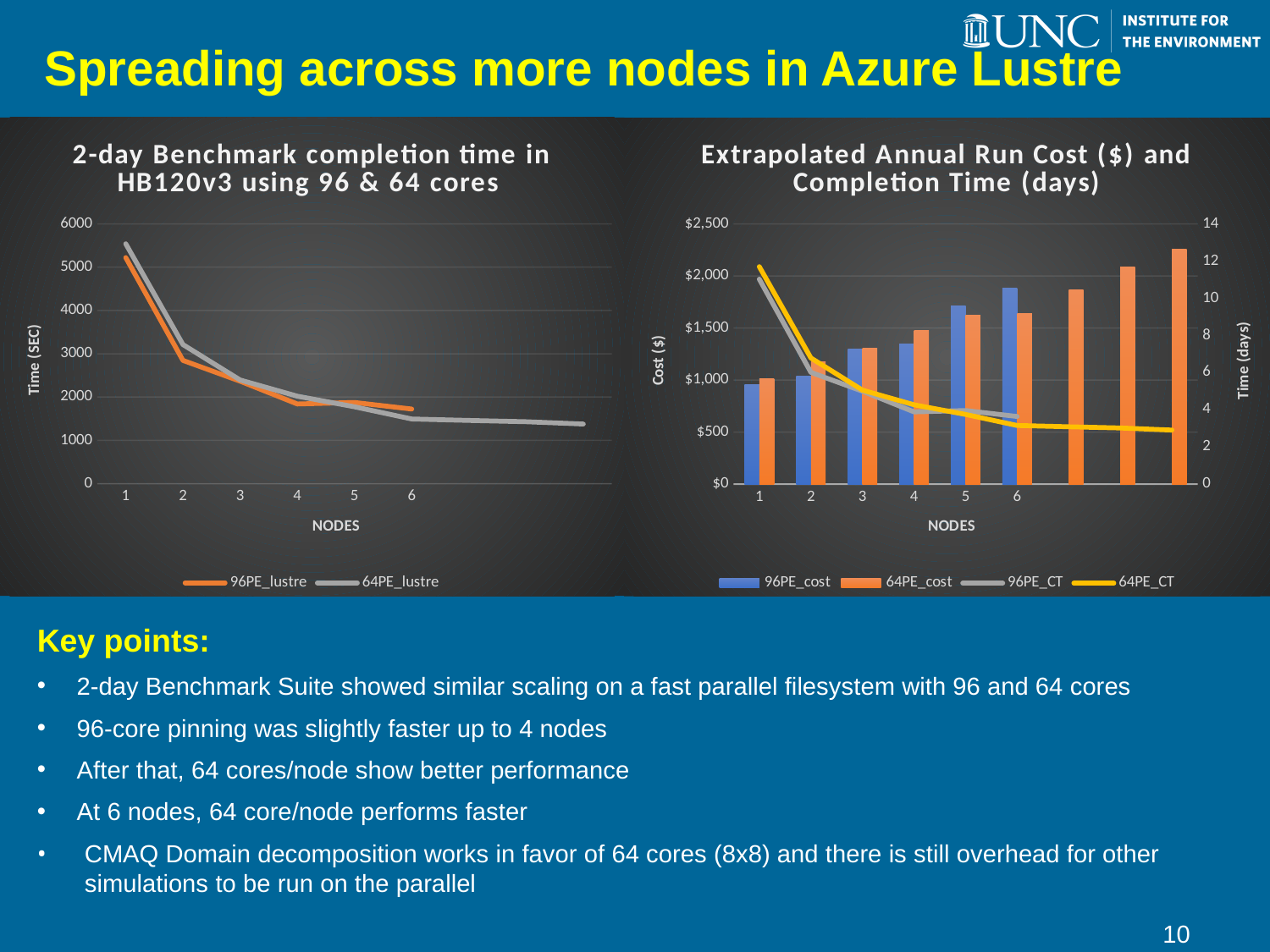
In the left chart, which series has the higher completion time at 1 node, 96PE_lustre or 64PE_lustre? 64PE_lustre In the left chart, is the 64PE_lustre value at 6 nodes greater or less than 2000? less In the right chart, is the 96PE_cost bar at 1 node greater or less than $500? greater What is the title of the secondary (right-hand) vertical axis of the right chart? Time (days) What kind of chart is the left chart titled '2-day Benchmark completion time in HB120v3 using 96 & 64 cores'? line chart In the right chart, is the 96PE_cost bar at 6 nodes greater or less than $1,500? greater How many series does the legend of the right chart 'Extrapolated Annual Run Cost ($) and Completion Time (days)' list? 4 In the right chart, does the 64PE_CT line rise or fall as the number of nodes increases? fall In the left chart, does the 96PE_lustre completion time rise or fall as the number of nodes increases? fall In the right chart, what colour are the 64PE_cost bars? orange How many series does the legend of the left chart list? 2